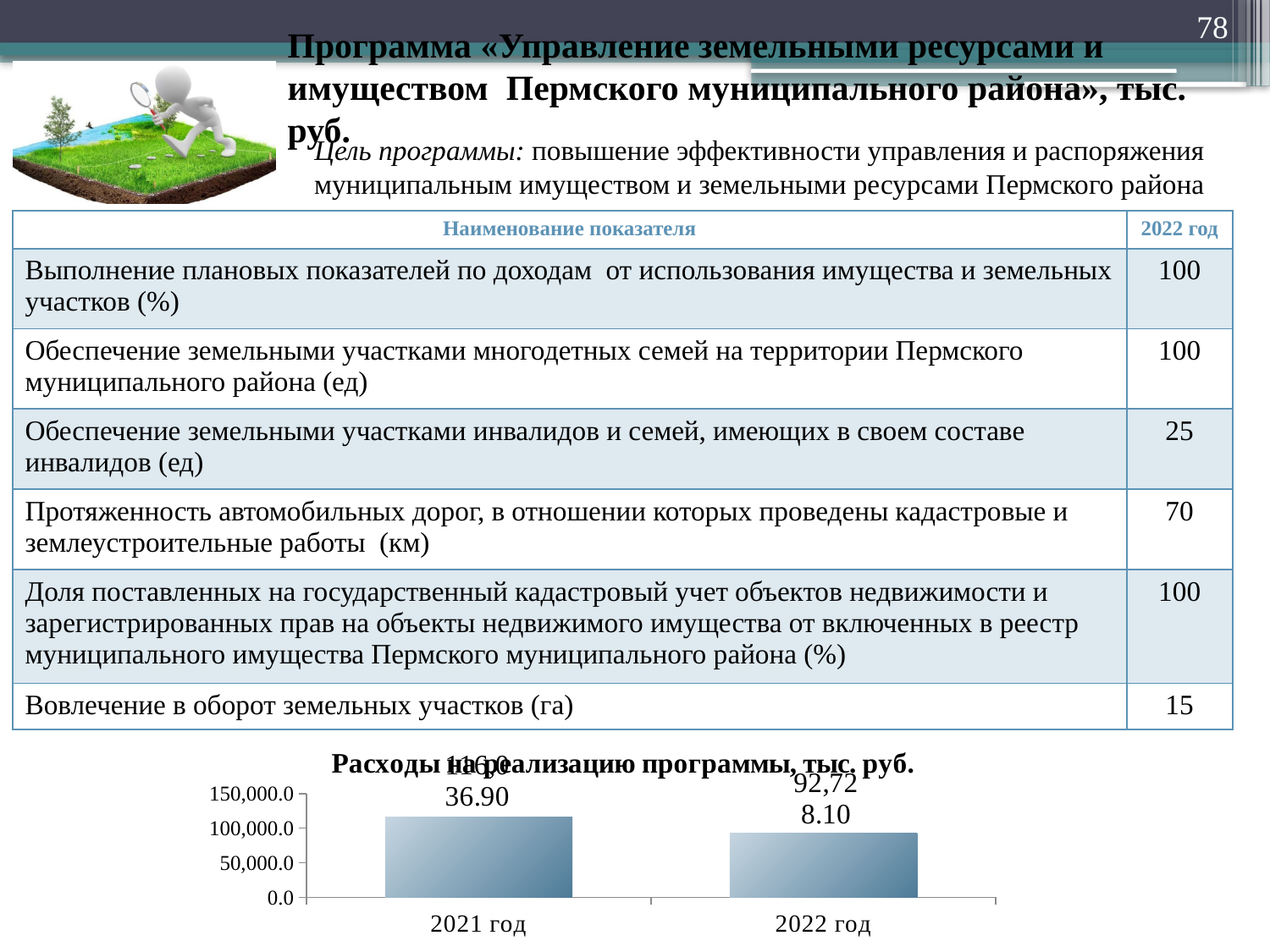
Which year has the lower expenditure in the chart 'Расходы на реализацию программы, тыс. руб.'? 2022 год In the chart 'Расходы на реализацию программы, тыс. руб.', which is larger: the value for 2021 год or for 2022 год? 2021 год Do the expenditures in the chart 'Расходы на реализацию программы, тыс. руб.' rise or fall from 2021 год to 2022 год? fall What kind of chart is shown at the bottom of the slide? bar chart Which year has the higher expenditure in the chart 'Расходы на реализацию программы, тыс. руб.'? 2021 год In the chart 'Расходы на реализацию программы, тыс. руб.', is the value for 2022 год greater or less than 50,000.0? greater How many bars (years) does the chart 'Расходы на реализацию программы, тыс. руб.' show? 2 In the chart 'Расходы на реализацию программы, тыс. руб.', is the value for 2021 год greater or less than 100,000.0? greater In the chart 'Расходы на реализацию программы, тыс. руб.', is the value for 2022 год greater or less than 100,000.0? less What is the title of the chart at the bottom of the slide? Расходы на реализацию программы, тыс. руб. What is the highest value shown on the vertical axis of the chart 'Расходы на реализацию программы, тыс. руб.'? 150,000.0